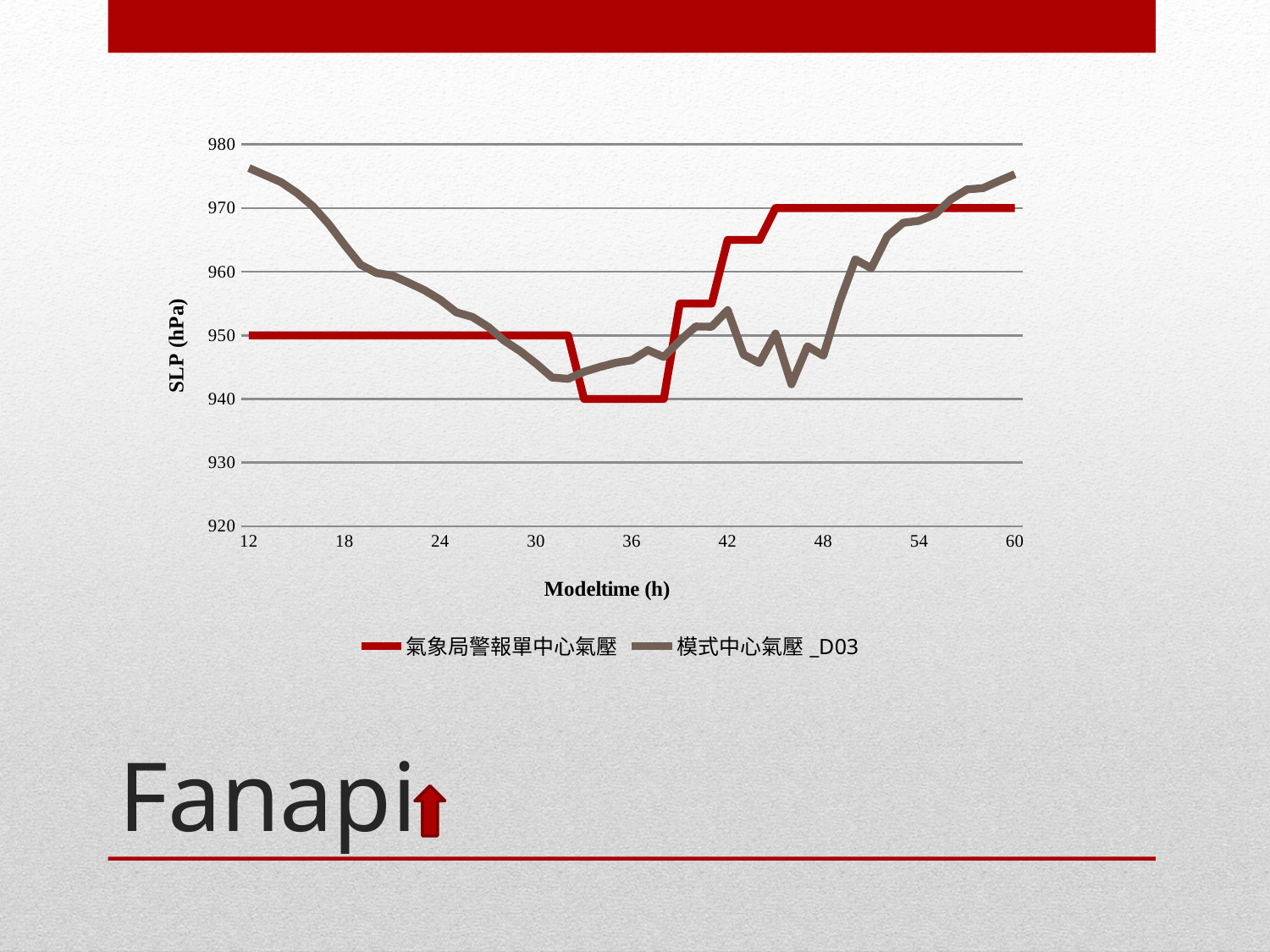
What is the title of the x axis? Modeltime (h) How many series does the legend list? 2 What is the value of 氣象局警報單中心氣壓 at model time 36 h? 940 At model time 12 h, which series has the higher value? 模式中心氣壓_D03 What kind of chart is shown on the slide? line chart What is the lowest value reached by the 氣象局警報單中心氣壓 series? 940 Does the 模式中心氣壓_D03 series rise or fall between model time 12 h and 30 h? fall What is the title of the y axis? SLP (hPa) What is the value of 氣象局警報單中心氣壓 at model time 60 h? 970 Is the value of 模式中心氣壓_D03 at model time 12 h greater or less than 970? greater What is the value of 氣象局警報單中心氣壓 at model time 12 h? 950